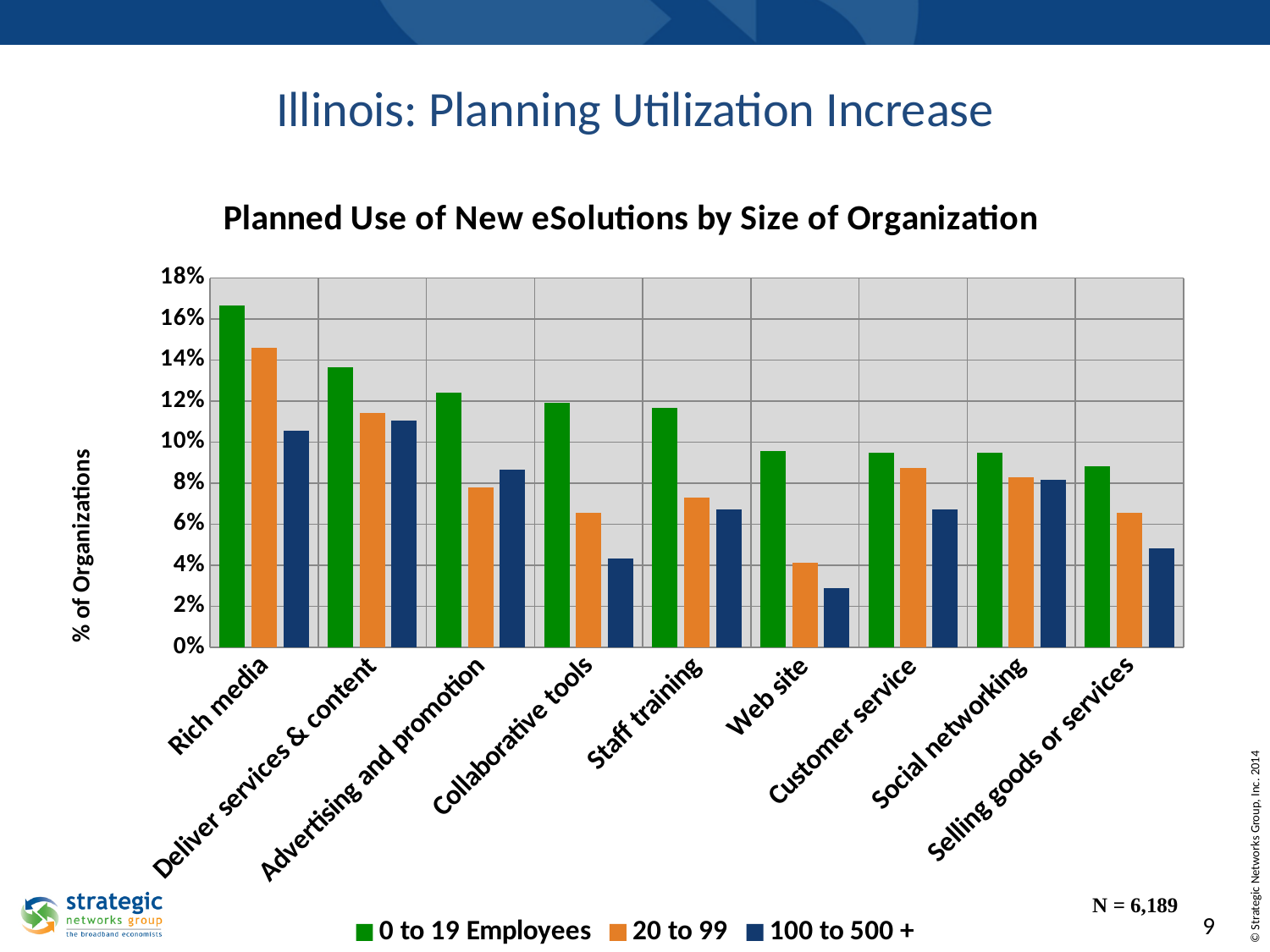
How many eSolution categories are shown on the x axis? 9 Do the values for the 0 to 19 Employees series generally rise or fall from left to right across the categories? fall What is the title of the chart? Planned Use of New eSolutions by Size of Organization For Advertising and promotion, which series has the larger value: 20 to 99 or 100 to 500 +? 100 to 500 + Is the value for Web site in the 100 to 500 + series greater or less than 4%? less Is the value for Rich media in the 0 to 19 Employees series greater or less than 16%? greater For Web site, which series has the larger value: 0 to 19 Employees or 20 to 99? 0 to 19 Employees How many series does the legend list? 3 What kind of chart is shown on the slide? Bar chart Which category has the highest value for the 0 to 19 Employees series? Rich media Is the value for Collaborative tools in the 0 to 19 Employees series greater or less than 10%? greater Which category has the lowest value for the 100 to 500 + series? Web site